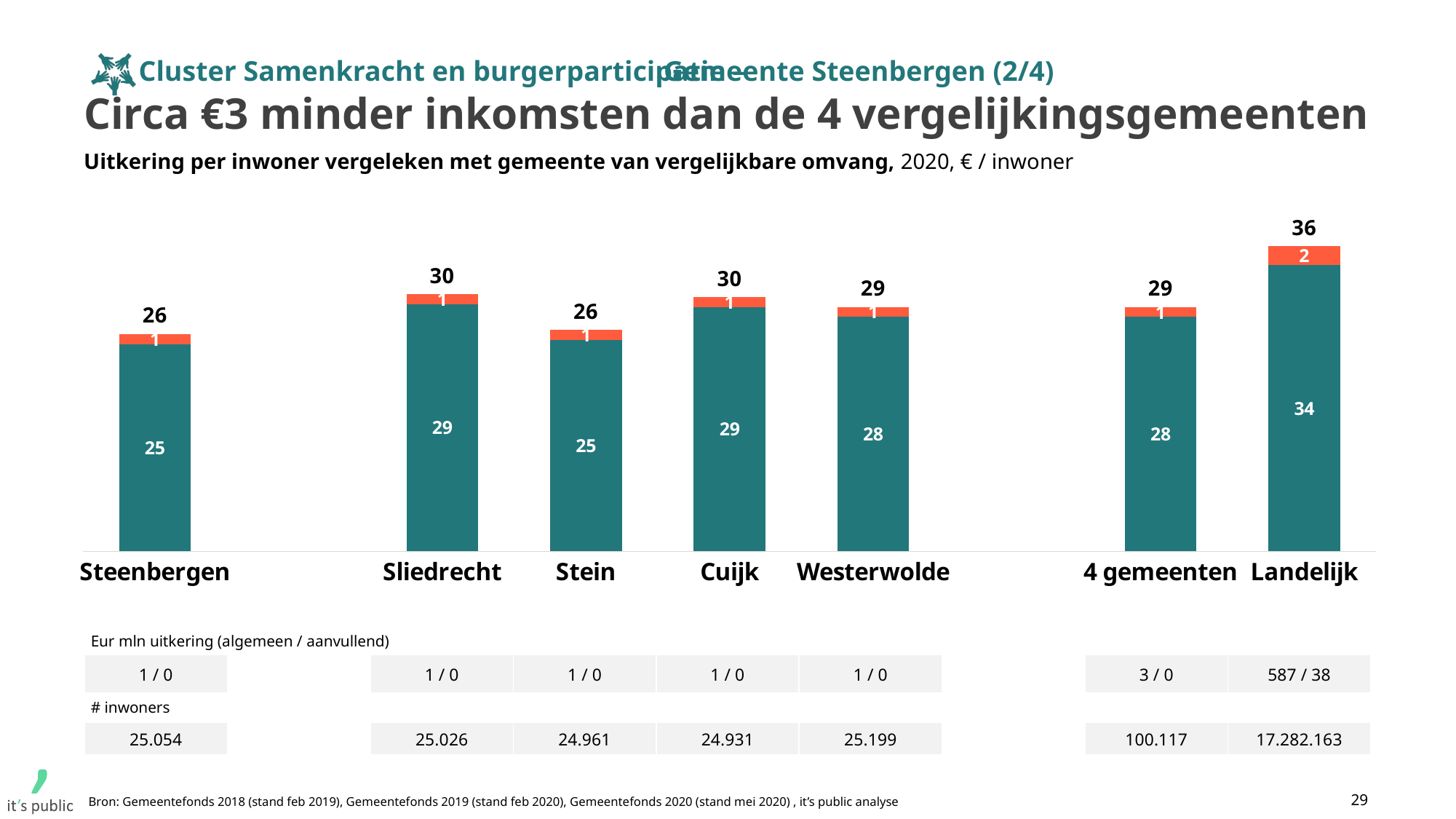
What is the difference between the total for 4 gemeenten and the total for Steenbergen? 3 Which is larger, the total for Sliedrecht or the total for Stein? Sliedrecht What is the difference between the total for Landelijk and the total for Steenbergen? 10 What is the total of the stacked bar for Cuijk (teal 29 plus orange 1)? 30 What is the total value shown above the bar for Landelijk? 36 What is the total value shown above the bar for Steenbergen? 26 Which category has the highest total value? Landelijk What kind of chart is shown on the slide? Stacked bar chart What is the value of the orange (upper) segment for Landelijk? 2 What is the value of the teal (lower) segment for Cuijk? 29 What is the value of the teal (lower) segment for Westerwolde? 28 How many categories are shown on the x axis of the chart? 7